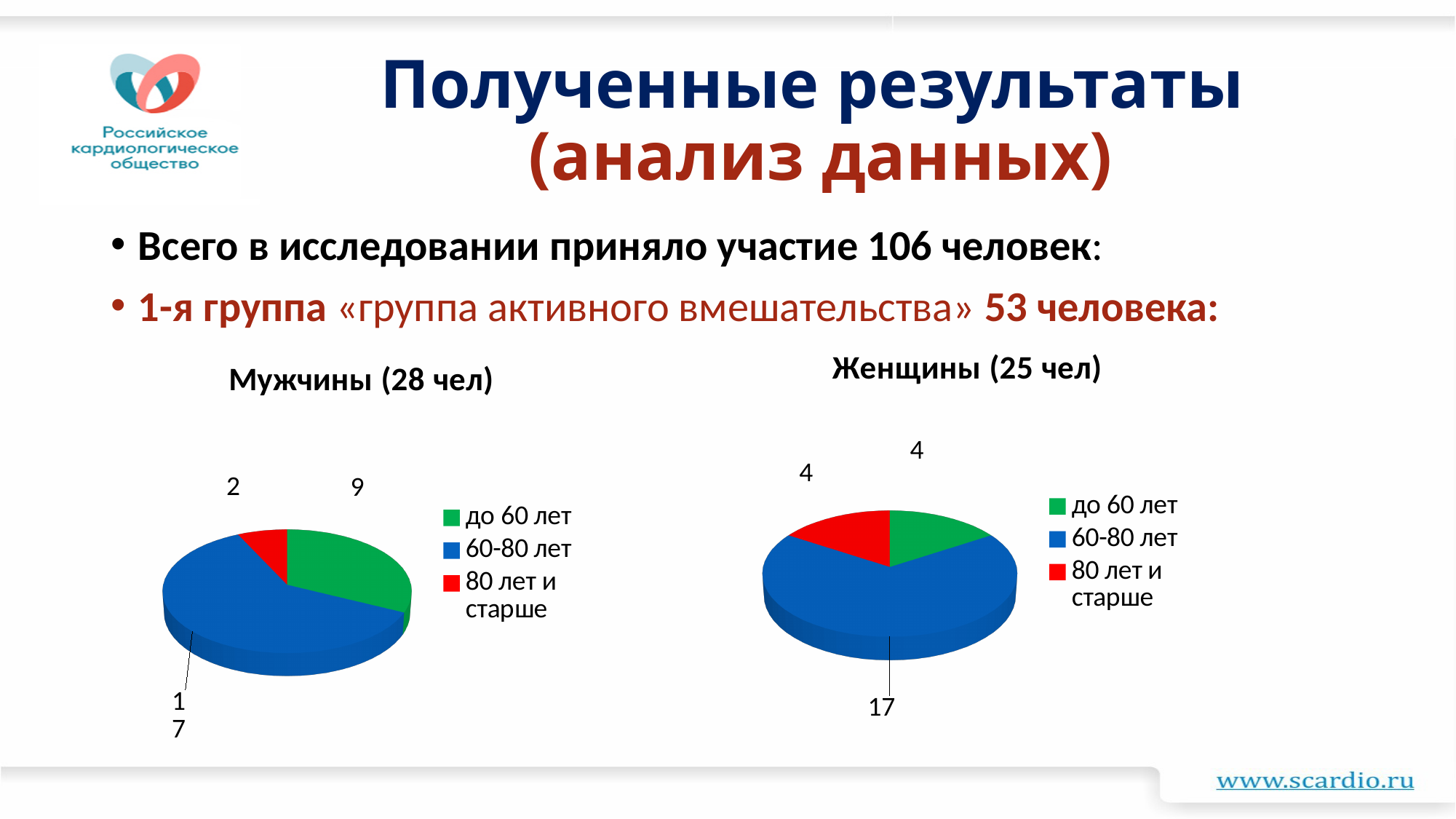
In the 'Женщины (25 чел)' pie chart, which category has the largest slice? 60-80 лет In the 'Мужчины (28 чел)' pie chart, what is the value for 'до 60 лет'? 9 In the 'Женщины (25 чел)' pie chart, what is the value for '60-80 лет'? 17 In the 'Женщины (25 чел)' pie chart, what share of the total does '60-80 лет' represent? 68% What type of chart is 'Мужчины (28 чел)'? Pie chart In the 'Мужчины (28 чел)' pie chart, what is the difference between the values for '60-80 лет' and 'до 60 лет'? 8 How many categories does the 'Женщины (25 чел)' pie chart have? 3 In the 'Женщины (25 чел)' pie chart, what is the value for '80 лет и старше'? 4 In the 'Мужчины (28 чел)' pie chart, what is the value for '60-80 лет'? 17 In the 'Мужчины (28 чел)' pie chart, which category has the largest slice? 60-80 лет Which is larger: the value for 'до 60 лет' in the 'Мужчины (28 чел)' chart or in the 'Женщины (25 чел)' chart? Мужчины (28 чел) In the 'Мужчины (28 чел)' pie chart, which category has the smallest slice? 80 лет и старше